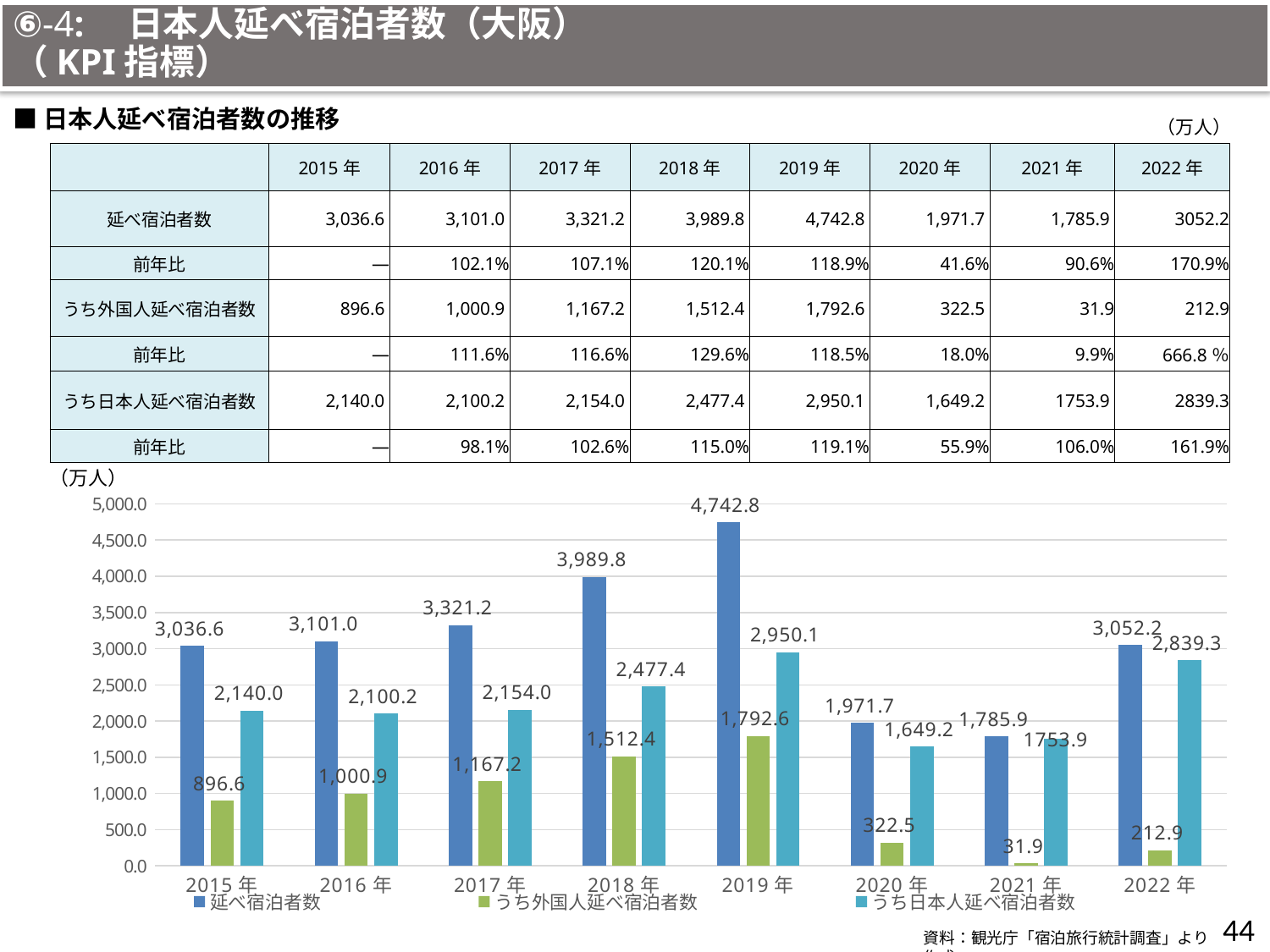
In the bar chart, what is the difference between the 延べ宿泊者数 values for 2019年 and 2020年? 2,771.1 In the bar chart, which year has the highest value for 延べ宿泊者数? 2019年 In the bar chart, what is the value of うち日本人延べ宿泊者数 for 2021年? 1753.9 In the bar chart, what is the value of 延べ宿泊者数 for 2019年? 4,742.8 In the bar chart, which is larger: うち日本人延べ宿泊者数 for 2022年 or for 2018年? 2022年 How many years are shown on the x axis of the bar chart? 8 In the bar chart, does 延べ宿泊者数 rise or fall from 2015年 to 2019年? Rise In the bar chart, what is the value of うち外国人延べ宿泊者数 for 2021年? 31.9 What kind of chart is shown on the slide? Bar chart How many series does the legend of the bar chart list? 3 In the bar chart, which year has the lowest value for うち外国人延べ宿泊者数? 2021年 In the bar chart, what is the difference between the うち外国人延べ宿泊者数 values for 2019年 and 2015年? 896.0